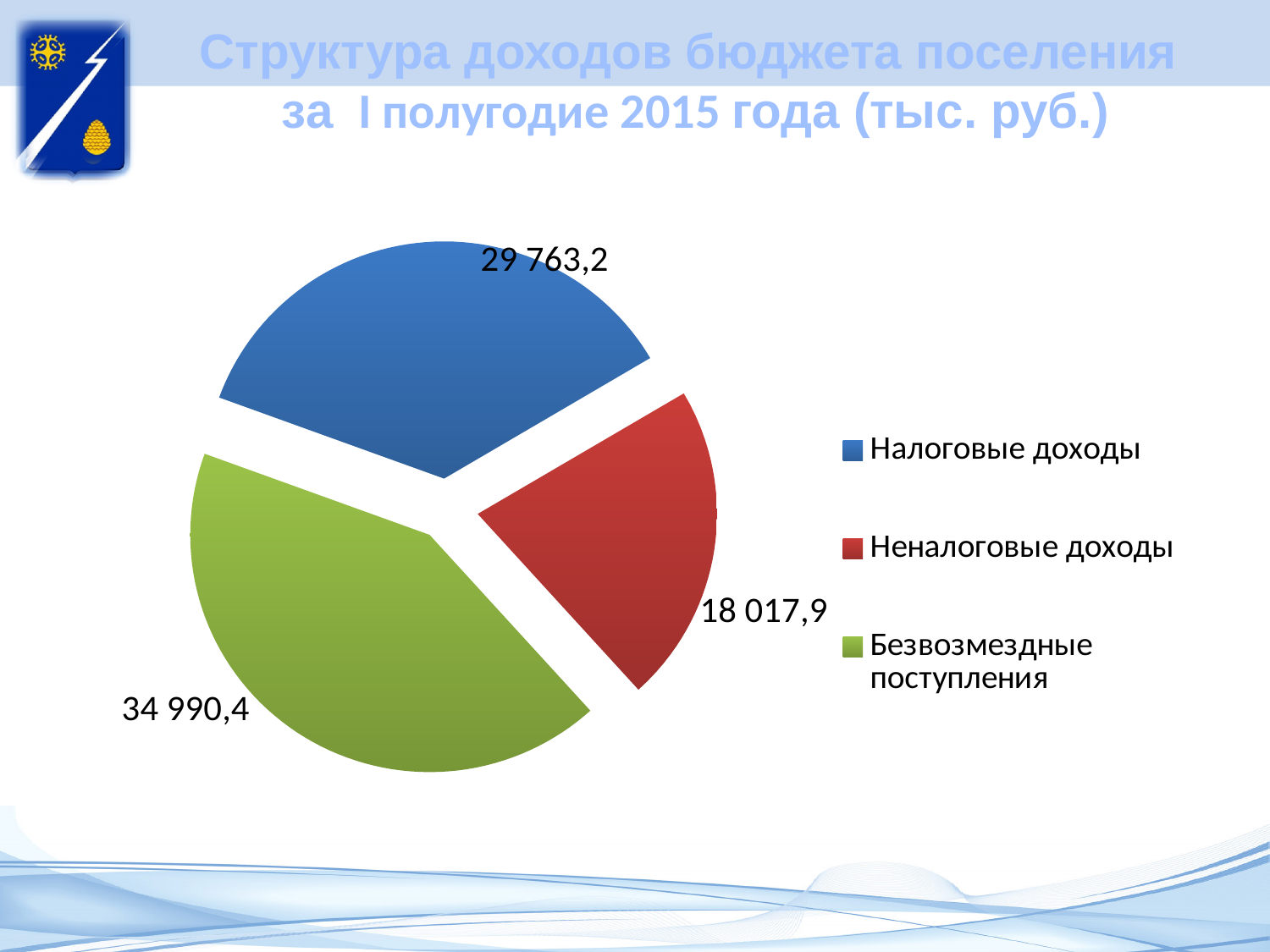
What is the difference between Безвозмездные поступления and Налоговые доходы? 5 227,2 What is the value for Налоговые доходы? 29 763,2 What type of chart is shown on the slide? Pie chart What is the value for Безвозмездные поступления? 34 990,4 What is the value for Неналоговые доходы? 18 017,9 Which category has the smallest value? Неналоговые доходы What is the difference between Налоговые доходы and Неналоговые доходы? 11 745,3 Which category has the largest value? Безвозмездные поступления How many entries does the legend list? 3 What colour is the slice for Безвозмездные поступления? Green Which is larger, Налоговые доходы or Неналоговые доходы? Налоговые доходы How many slices does the pie chart have? 3